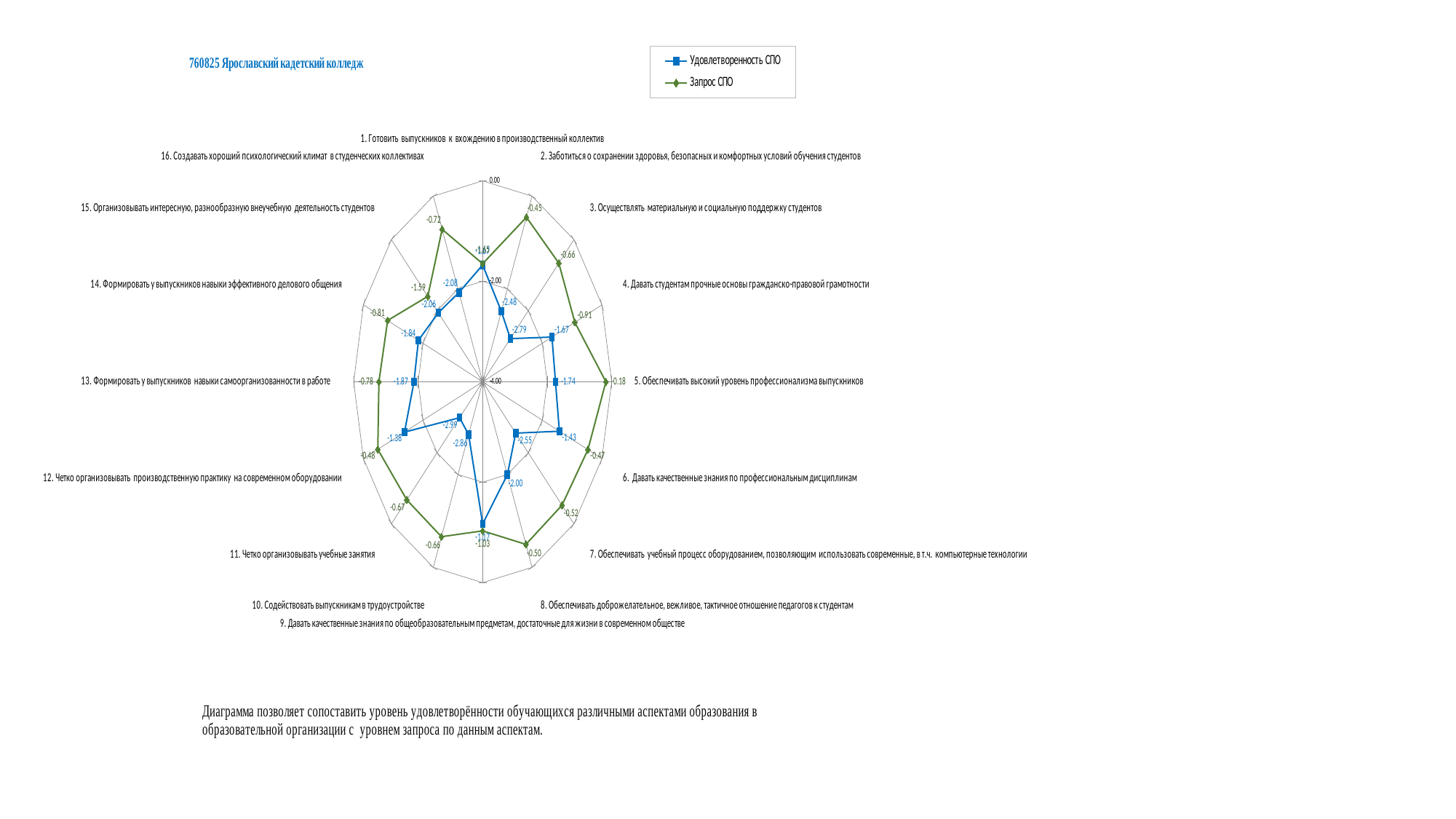
How many categories (axes) does the radar chart have? 16 How many series does the legend list? 2 What is the difference between "Запрос СПО" and "Удовлетворенность СПО" for category 5 (Обеспечивать высокий уровень профессионализма выпускников)? 1.56 What is the value of "Удовлетворенность СПО" for category 5 (Обеспечивать высокий уровень профессионализма выпускников)? -1.74 What is the value of "Запрос СПО" for category 13 (Формировать у выпускников навыки самоорганизованности в работе)? -0.78 For which category does "Запрос СПО" have its highest value? 5. Обеспечивать высокий уровень профессионализма выпускников For which category does "Удовлетворенность СПО" have its lowest value? 11. Четко организовывать учебные занятия What is the value of "Запрос СПО" for category 4 (Давать студентам прочные основы гражданско-правовой грамотности)? -0.91 What is the value of "Удовлетворенность СПО" for category 11 (Четко организовывать учебные занятия)? -2.99 What kind of chart is shown on the slide? Radar chart What is the value of "Запрос СПО" for category 5 (Обеспечивать высокий уровень профессионализма выпускников)? -0.18 Which series is shown with green diamond markers? Запрос СПО